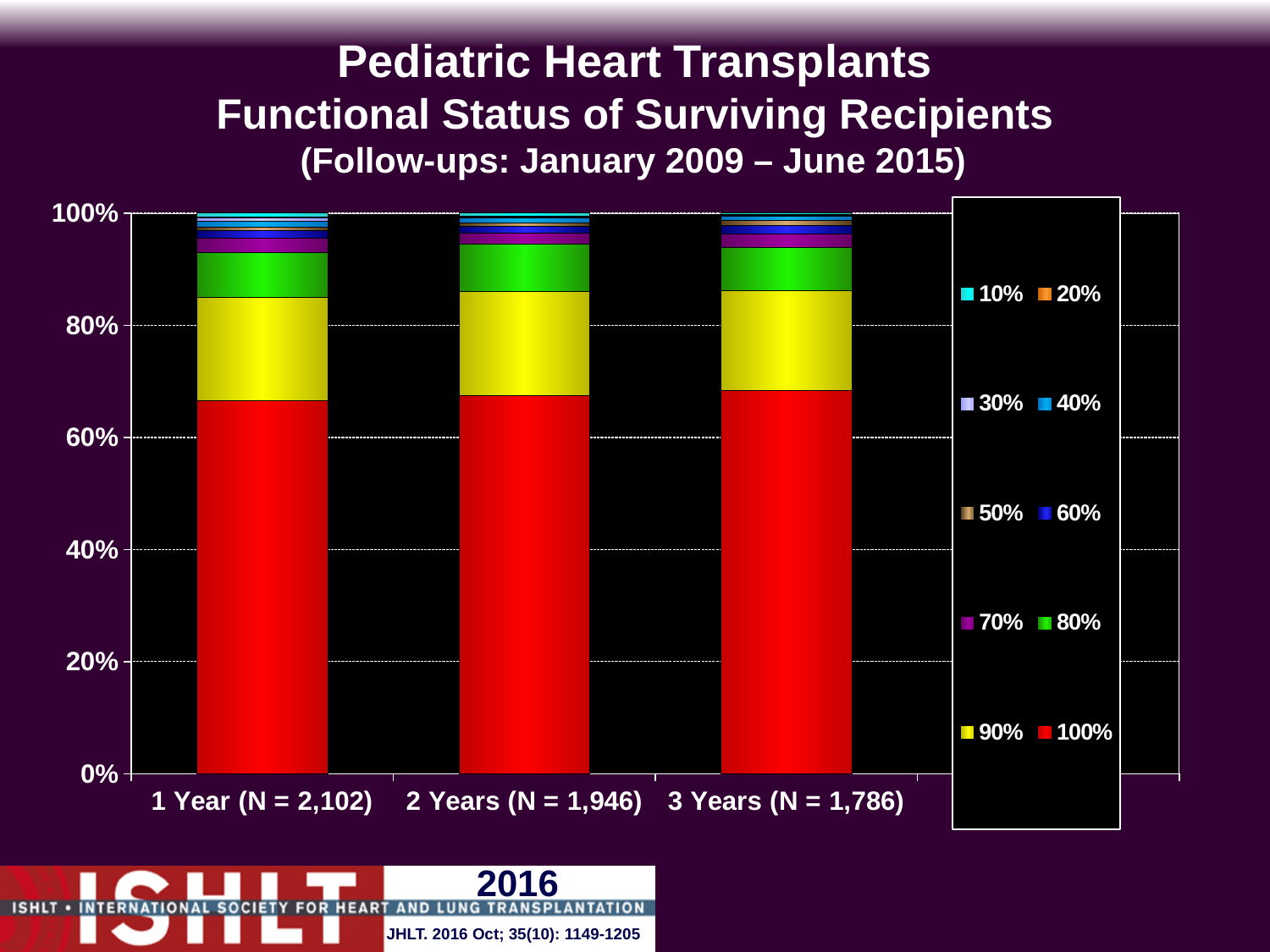
Which functional status series occupies the largest portion of each bar? 100% What is the total height of each stacked bar on the y axis? 100% Which is larger in the 1 Year bar: the 100% segment or the 90% segment? 100% segment What is the number of recipients (N) for the 1 Year category? 2,102 Is the value of the 100% functional status segment for 3 Years greater or less than 80%? less Is the value of the 100% functional status segment for 1 Year greater or less than 60%? greater How many categories (follow-up time points) are shown on the x axis? 3 Is the top of the 90% segment in the 1 Year bar above or below the 80% gridline? above What kind of chart is shown on the slide? Stacked bar chart What is the number of recipients (N) for the 3 Years category? 1,786 How many series does the legend list? 10